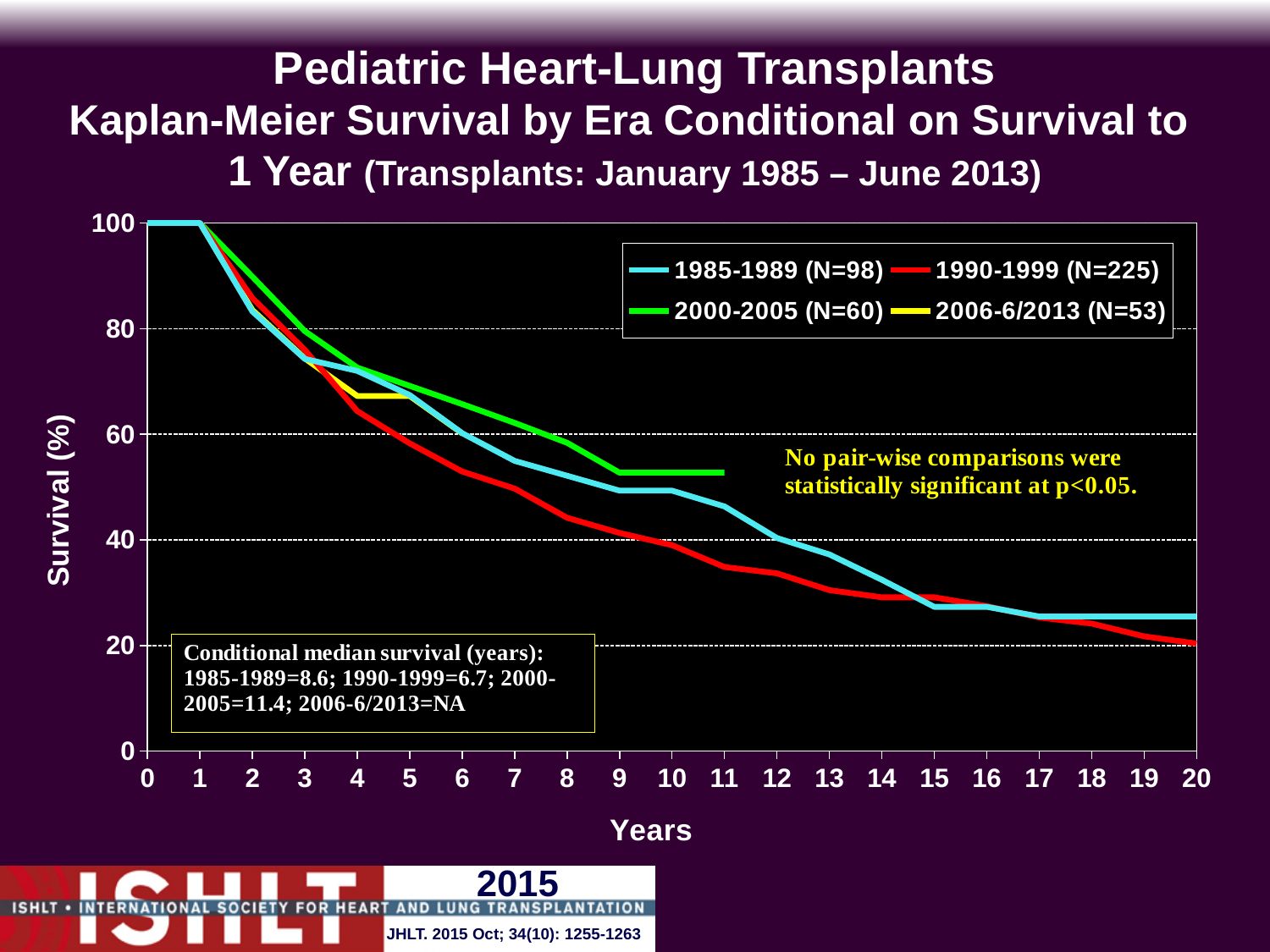
Is the survival value for the 1990-1999 era at 20 years greater or less than 40? less How many series (eras) does the legend list? 4 What is the difference in conditional median survival (years) between the 1985-1989 era and the 1990-1999 era? 1.9 What is the N for the 1990-1999 era shown in the legend? 225 Do the survival curves rise or fall as years increase along the x axis? fall What colour is the line for the 2006-6/2013 era? Yellow What is the conditional median survival in years for the 2000-2005 era? 11.4 What is the conditional median survival for the 2006-6/2013 era? NA At 5 years, which era has higher survival: 2000-2005 or 1990-1999? 2000-2005 Which era has the highest conditional median survival listed in the text box? 2000-2005 What is the N for the 1985-1989 era shown in the legend? 98 What kind of chart is shown on the slide? Line chart